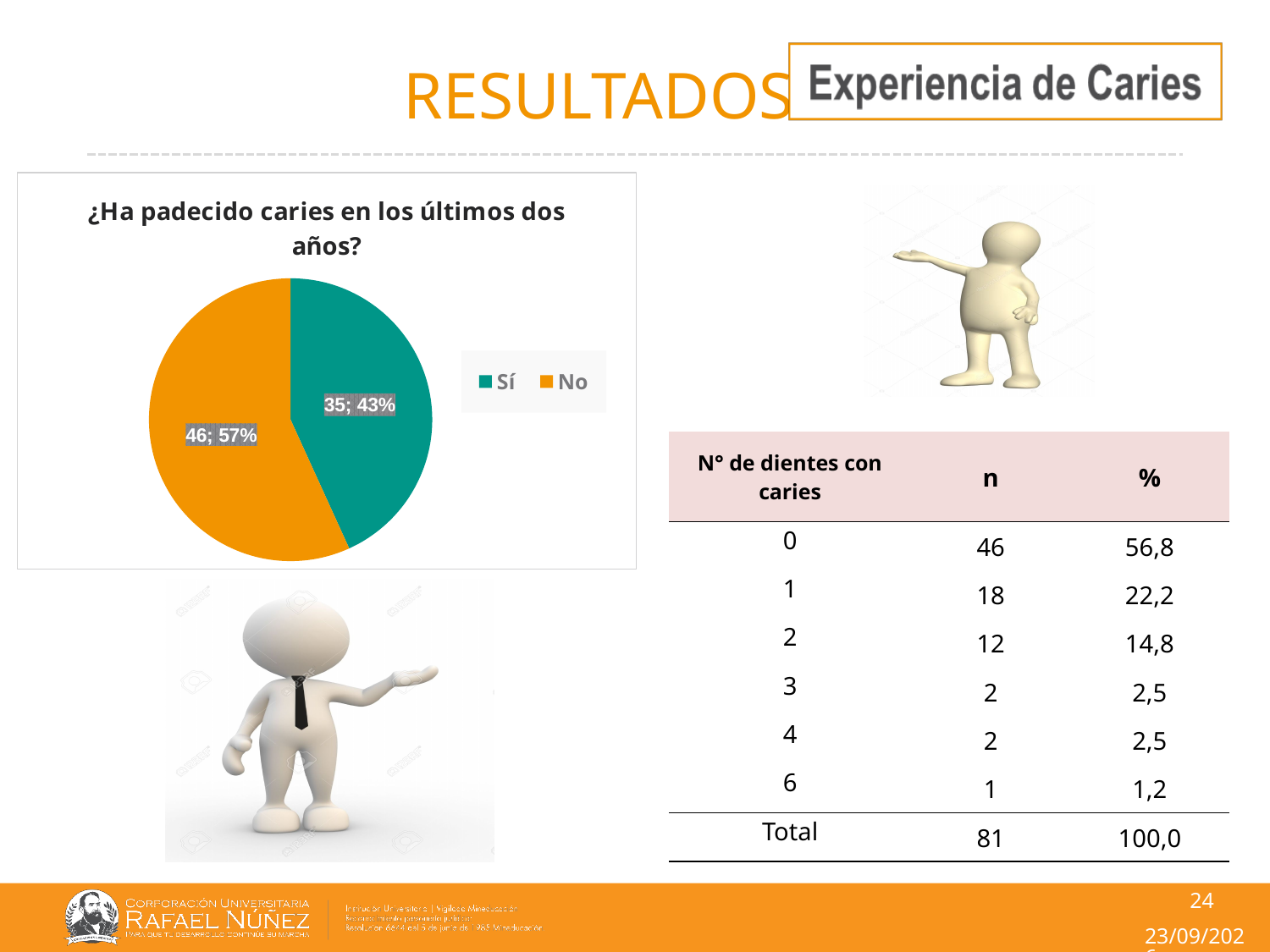
What percentage share does the "No" slice represent in the pie chart? 57% Which slice of the pie chart is the largest? No What is the count shown for the "No" slice of the pie chart? 46 What is the difference between the counts for "No" and "Sí" in the pie chart? 11 What is the count shown for the "Sí" slice of the pie chart? 35 Which colour represents the "No" slice in the pie chart? orange How many slices does the pie chart have? 2 What percentage share does the "Sí" slice represent in the pie chart? 43% Which slice of the pie chart is the smallest? Sí What kind of chart is shown on the slide? pie chart What is the title of the pie chart? ¿Ha padecido caries en los últimos dos años? How many series does the legend of the pie chart list? 2